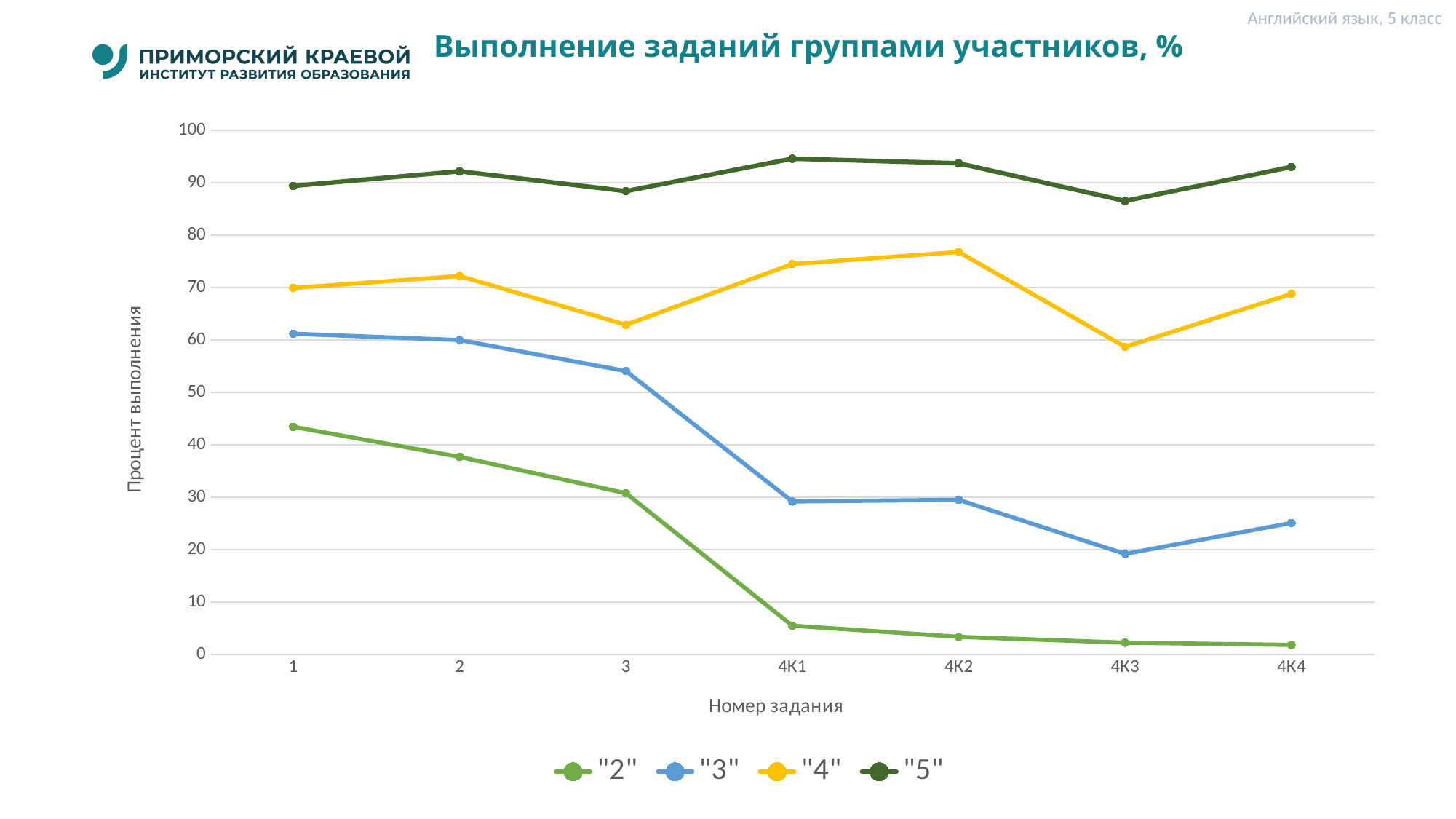
For series "5", at which task is the value lowest? 4К3 How many task numbers are shown along the x axis? 7 Is the value for series "2" at task 4К1 greater or less than 10? less Is the value for series "5" at task 4К1 greater or less than 90? greater Do the values for series "2" rise or fall from task 1 to task 4К4? fall What is the title of the vertical axis? Процент выполнения For series "4", at which task is the value highest? 4К2 How many series does the legend list? 4 What kind of chart is shown on the slide? line chart At task 3, which series has the larger value, "3" or "4"? "4" Is the value for series "2" at task 1 greater or less than 40? greater